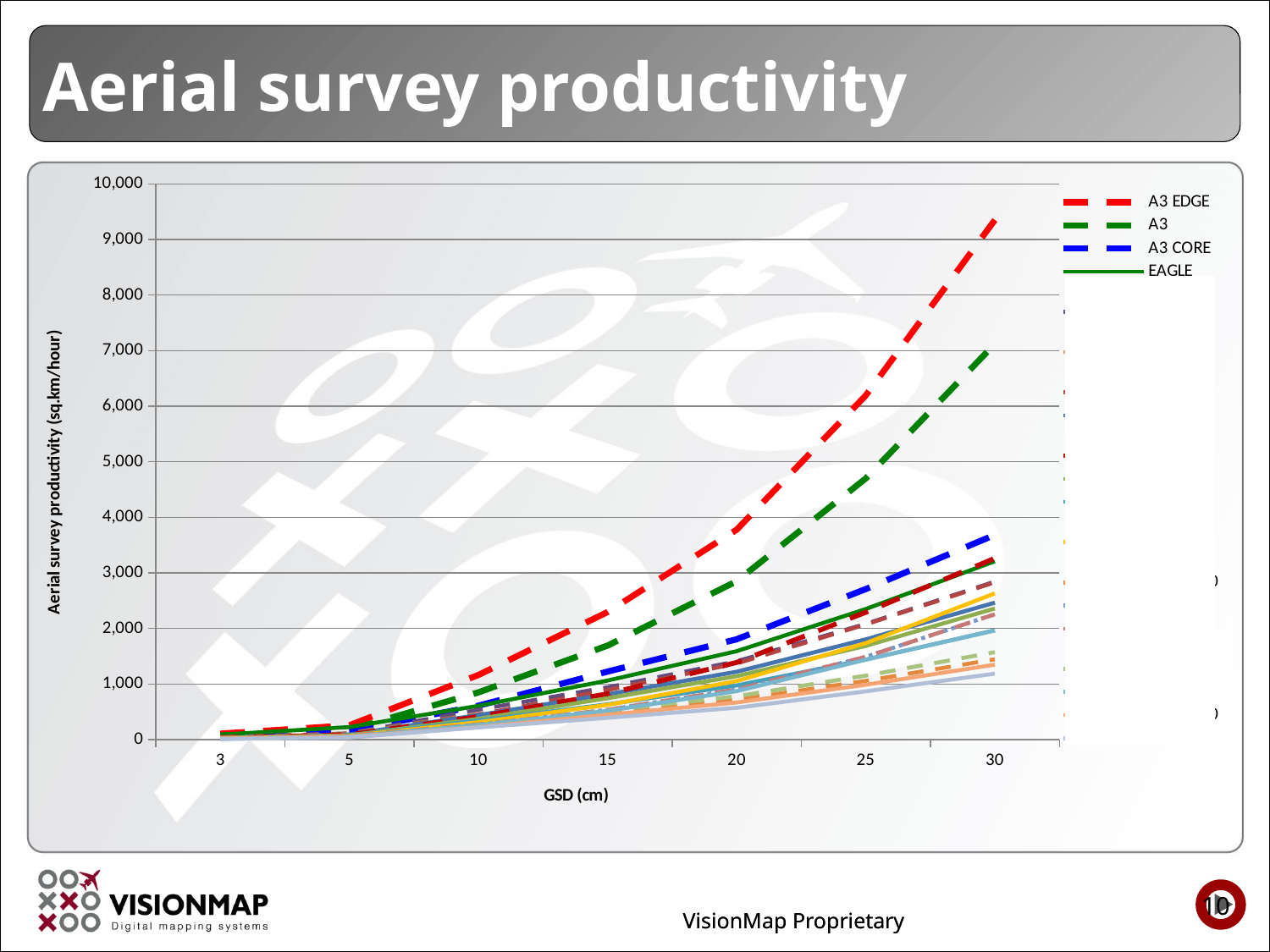
Is the value for EAGLE at a GSD of 30 cm greater or less than 4,000? less How many GSD values are marked as ticks on the x axis? 7 At a GSD of 20 cm, which is larger: the value for A3 or the value for A3 CORE? A3 What is the title of the chart on the slide? Aerial survey productivity Is the value for A3 EDGE at a GSD of 30 cm greater or less than 9,000? greater What kind of chart is shown on the slide? line chart At a GSD of 30 cm, which is larger: the value for A3 EDGE or the value for A3? A3 EDGE Is the value for A3 at a GSD of 30 cm greater or less than 6,000? greater What is the label of the x axis of the chart? GSD (cm) Do the productivity values rise or fall as GSD increases along the x axis? rise Which series has the highest productivity at a GSD of 30 cm? A3 EDGE